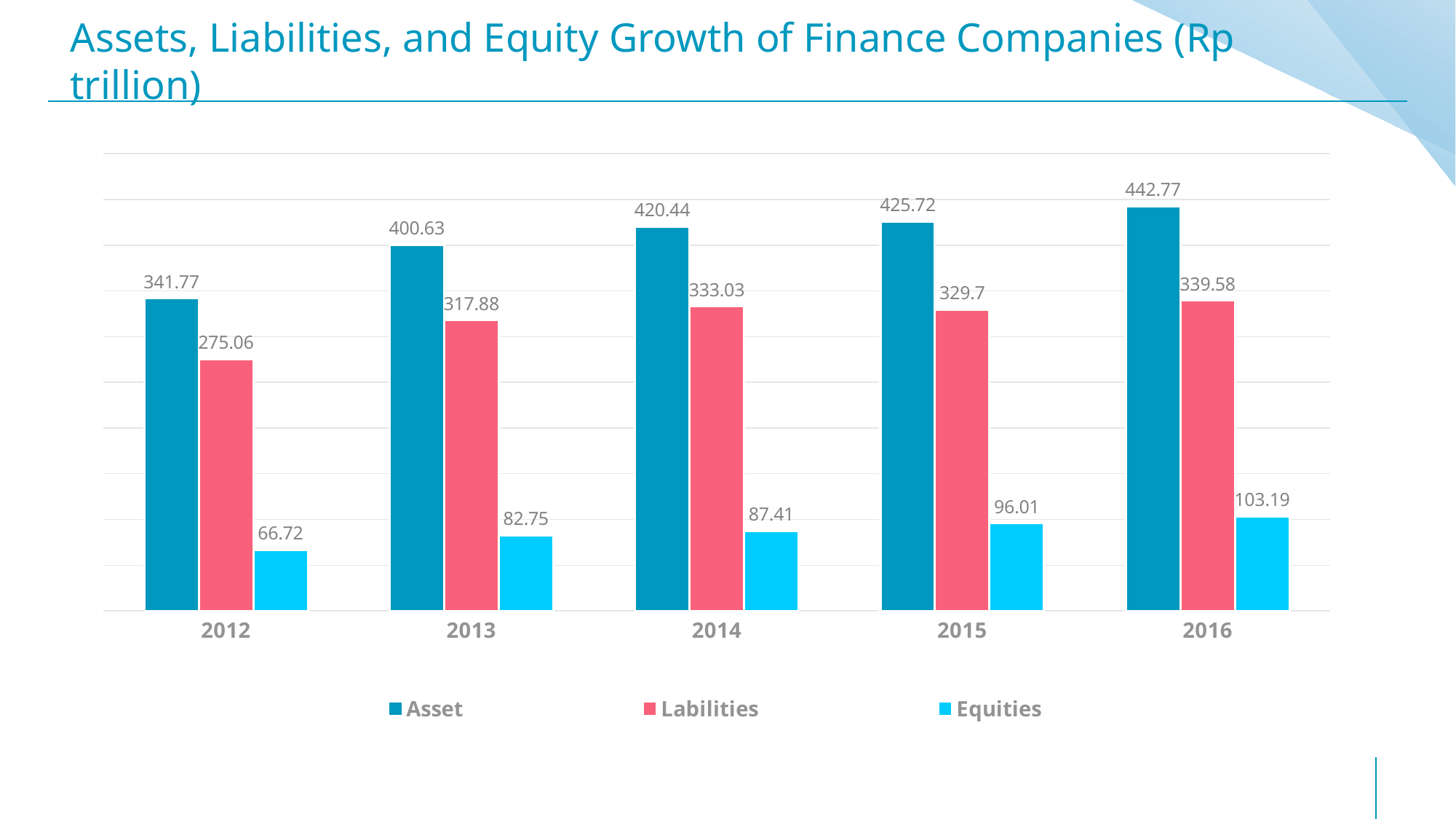
Which year has the highest Asset value? 2016 What is the difference between the Liabilities value and the Equities value in 2015? 233.69 What is the Asset value for 2014? 420.44 Which is larger, the Liabilities value in 2013 or the Liabilities value in 2015? Liabilities in 2015 Which year has the lowest Equities value? 2012 How many series does the legend list? 3 What is the Liabilities value for 2012? 275.06 What is the Equities value for 2016? 103.19 What kind of chart is shown on the slide? Bar chart How many years are shown on the x axis? 5 What is the difference between the Asset value in 2016 and the Asset value in 2012? 101 Do the Equities values rise or fall from 2012 to 2016? Rise